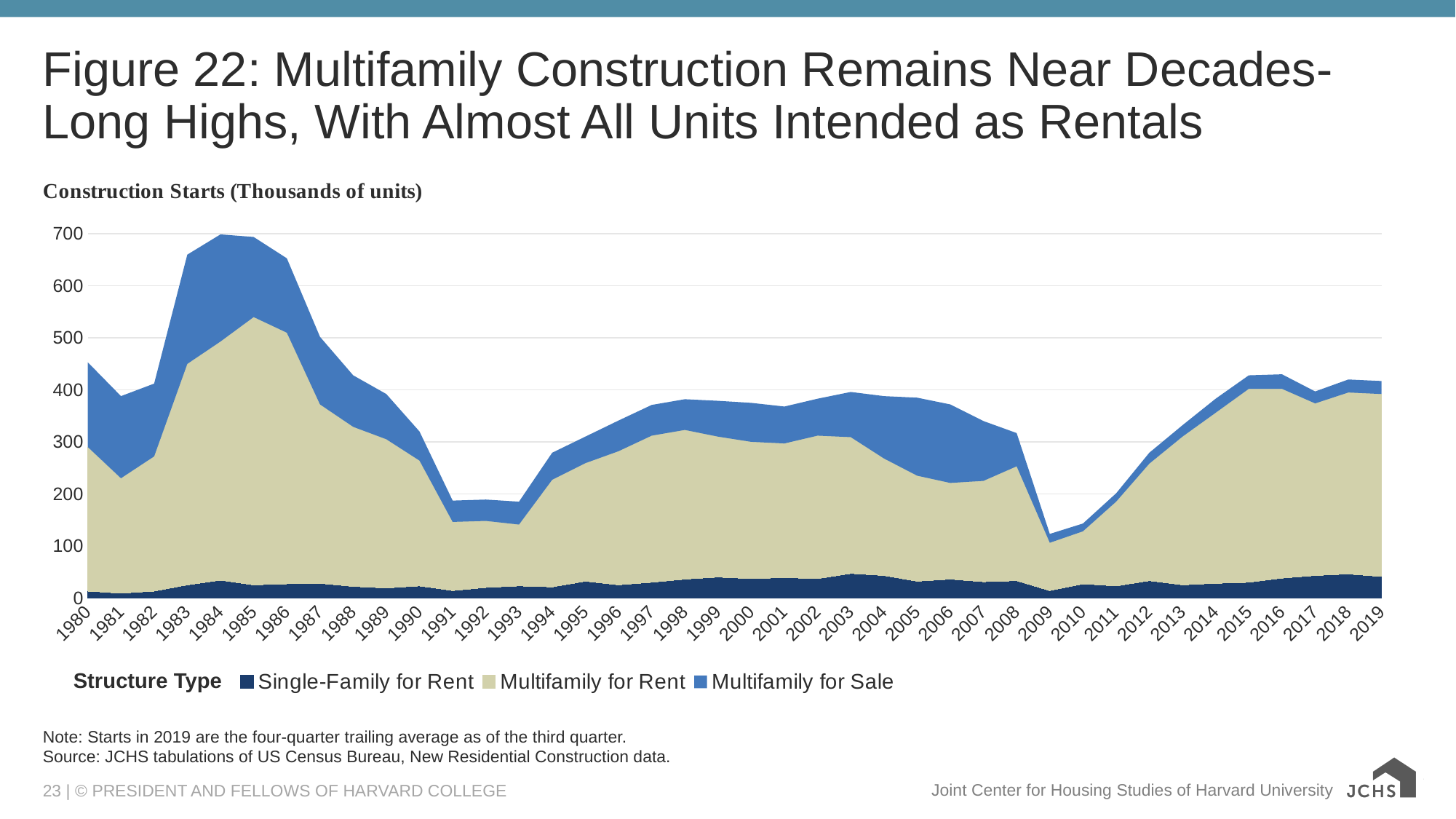
Do total construction starts rise or fall from 2009 to 2015? Rise Which series is shown in the light tan colour? Multifamily for Rent What is the label of the y axis? Construction Starts (Thousands of units) What kind of chart is shown on the slide? Stacked area chart Which year has a larger total of construction starts, 1984 or 2019? 1984 In which year does total construction starts reach its lowest point? 2009 How many years are plotted along the x axis? 40 Is the total value for 1980 greater or less than 400? greater Is the total value for 1984 greater or less than 600? greater Is the total value for 2009 greater or less than 200? less How many series does the legend list? 3 In which year does total construction starts reach its highest point? 1984